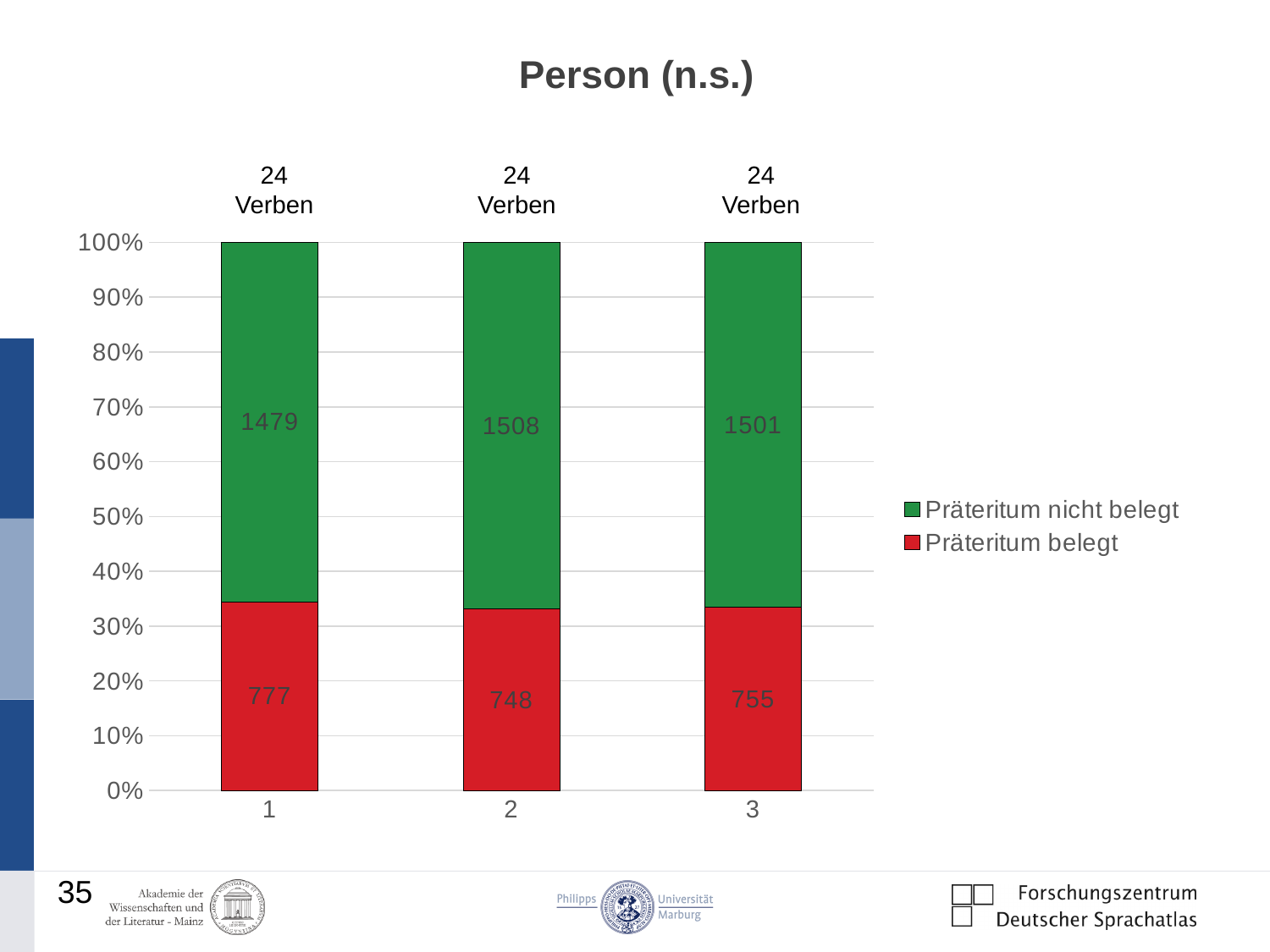
Is the "Präteritum belegt" value for category 1 larger or smaller than for category 3? larger Which category has the lowest value for "Präteritum belegt"? 2 What is the total of the two labelled values in the bar for category 1? 2256 What is the value of "Präteritum belegt" for category 3? 755 Which category has the highest value for "Präteritum nicht belegt"? 2 What is the value of "Präteritum nicht belegt" for category 2? 1508 What is the title of the chart? Person (n.s.) How many series does the legend list? 2 What is the value of "Präteritum belegt" for category 1? 777 What kind of chart is shown on the slide? stacked bar chart What is the difference between the "Präteritum nicht belegt" values for category 2 and category 1? 29 How many categories are shown on the x axis? 3